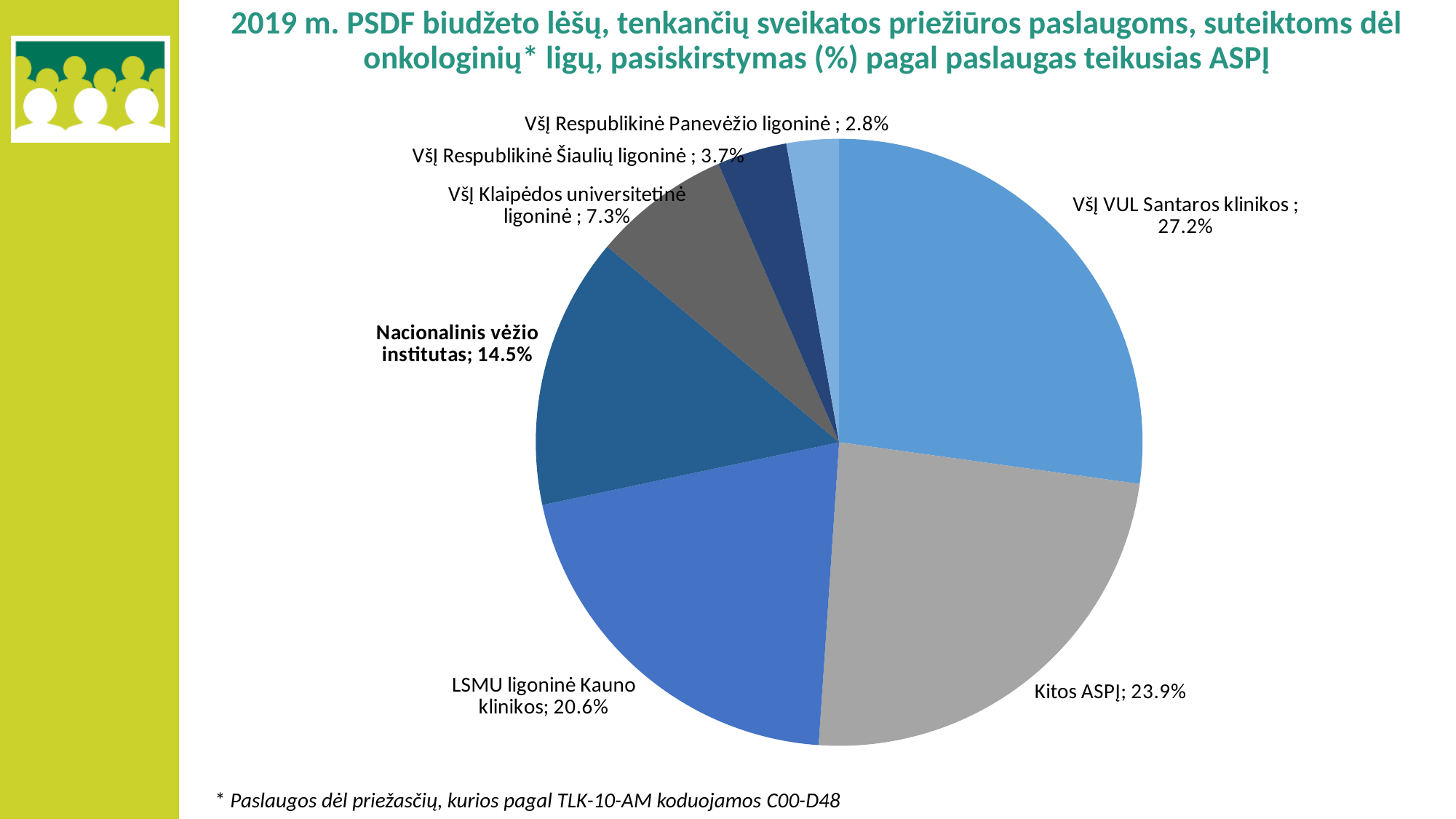
What is the value for VšĮ Klaipėdos universitetinė ligoninė? 7.3% What is the value for LSMU ligoninė Kauno klinikos? 20.6% What is the difference between the values for VšĮ VUL Santaros klinikos and Kitos ASPĮ? 3.3% What type of chart is shown on the slide? pie chart Which category has the largest slice of the pie? VšĮ VUL Santaros klinikos What is the value for Nacionalinis vėžio institutas? 14.5% What is the value for Kitos ASPĮ? 23.9% Which is larger, the value for LSMU ligoninė Kauno klinikos or the value for Nacionalinis vėžio institutas? LSMU ligoninė Kauno klinikos Which category has the smallest slice of the pie? VšĮ Respublikinė Panevėžio ligoninė What is the difference between the values for VšĮ Respublikinė Šiaulių ligoninė and VšĮ Respublikinė Panevėžio ligoninė? 0.9% What share of the pie does VšĮ VUL Santaros klinikos have? 27.2% How many slices does the pie chart have? 7